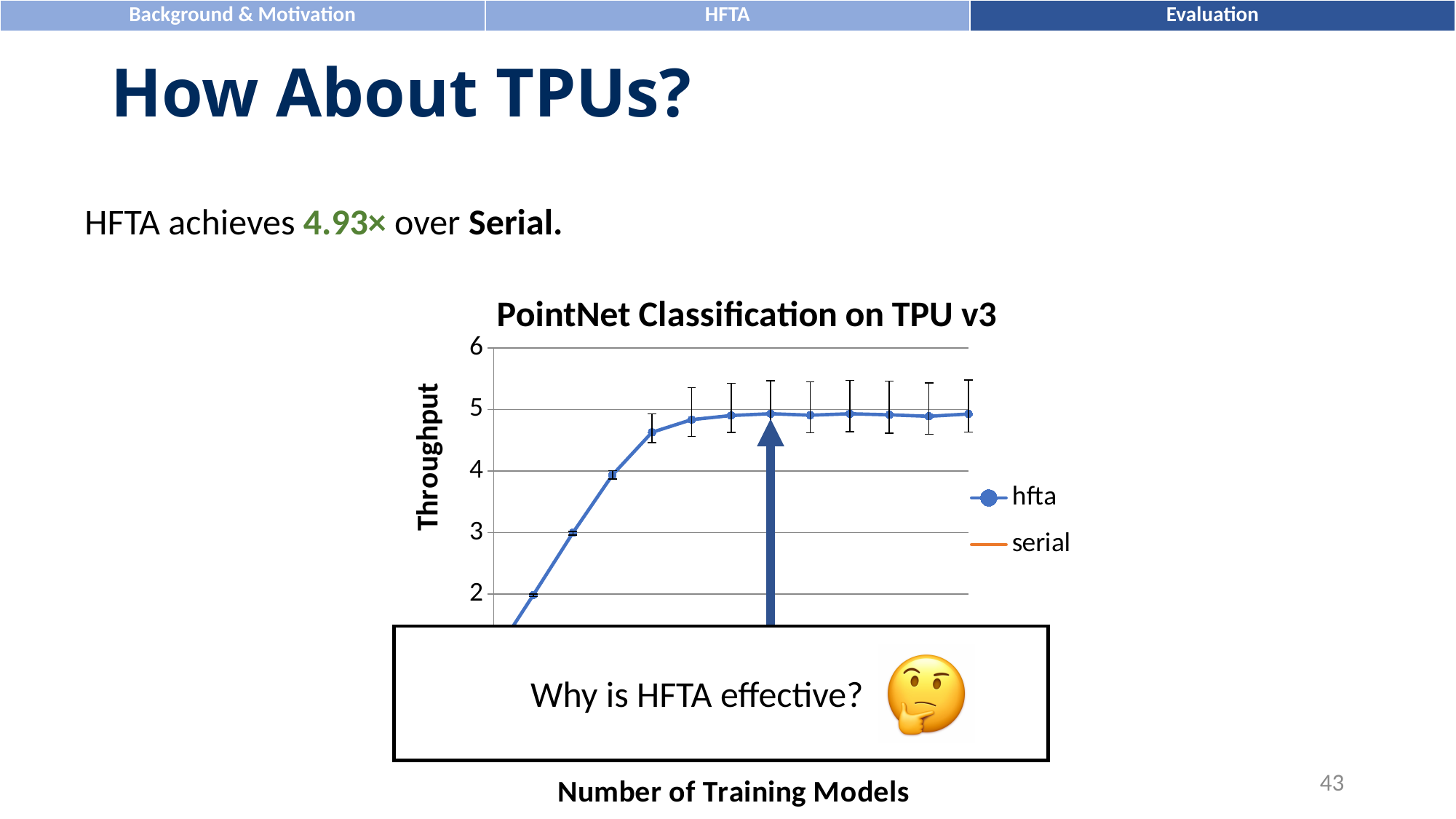
How many series does the legend of the chart list? 2 Is the highest value of the hfta series greater or less than 4? greater Is the leftmost visible hfta point greater or less than 3? less What is the title of the chart? PointNet Classification on TPU v3 Is the rightmost hfta point greater or less than 6? less Does the hfta series rise or fall as the number of training models increases? rise What are the two entries in the chart's legend? hfta and serial What kind of chart is shown on the slide? line chart